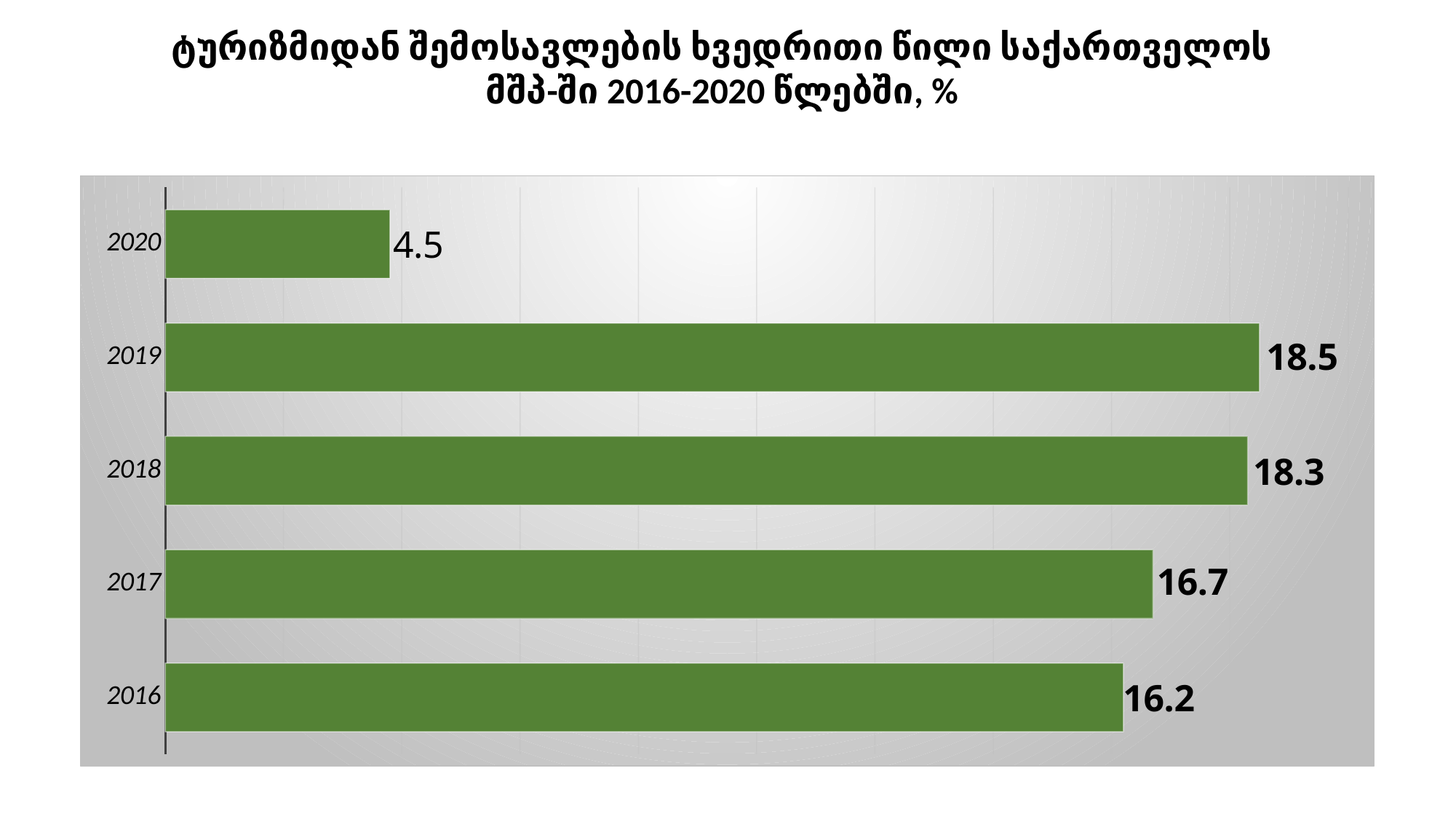
Which year has the lowest value? 2020 Which year has the highest value? 2019 What is the difference between the values for 2019 and 2020? 14 What is the difference between the values for 2018 and 2017? 1.6 What is the value for 2016? 16.2 What colour are the bars in the chart? Green Which is larger, the value for 2017 or the value for 2016? 2017 What kind of chart is shown on the slide? Bar chart What is the value for 2019? 18.5 What is the value for 2017? 16.7 How many years are shown in the chart? 5 What is the value for 2020? 4.5